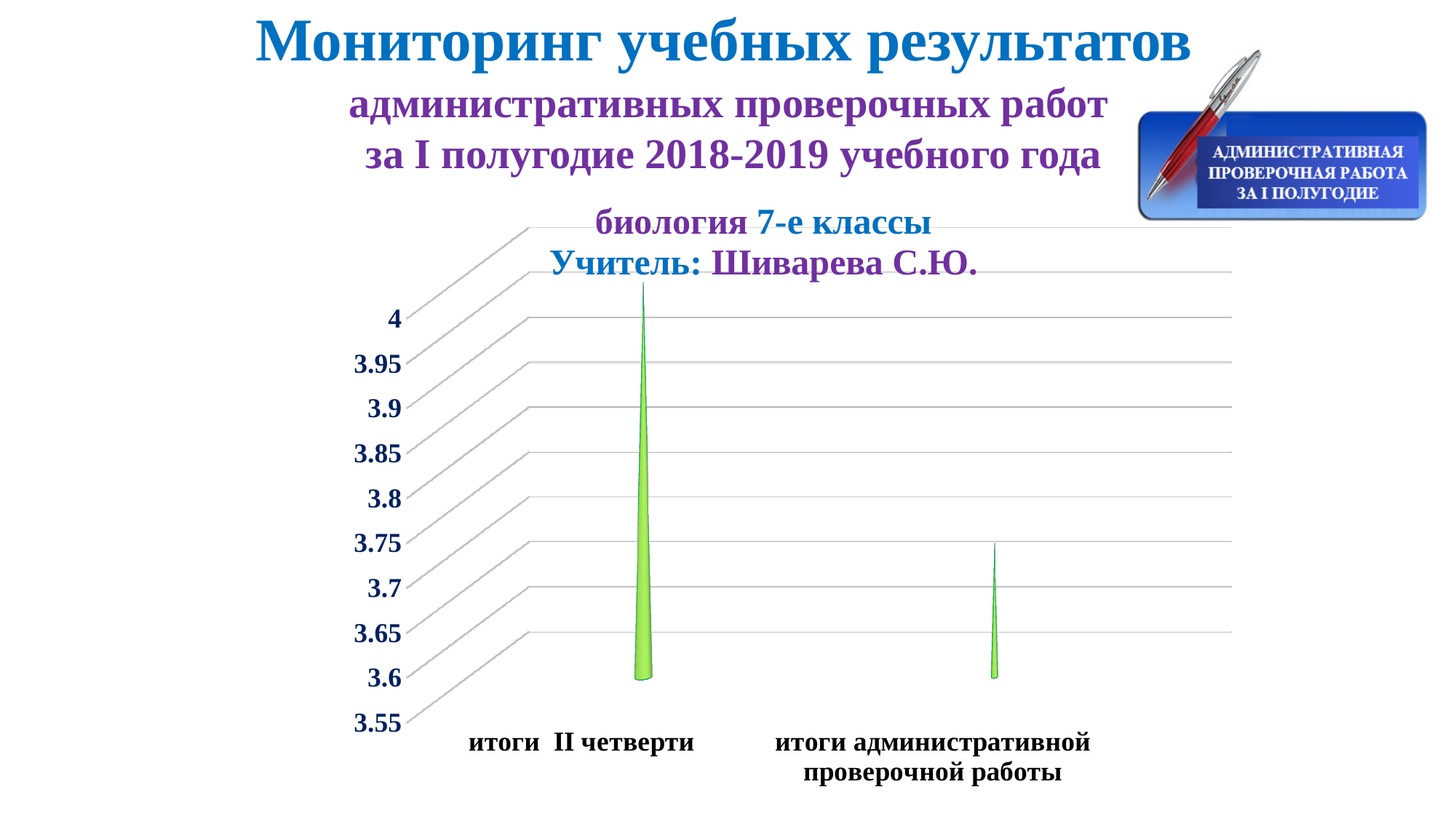
Which subject and classes does the chart title say the results are for? биология 7-е классы Is the value for "итоги административной проверочной работы" greater or less than 3.65? greater What kind of chart is shown on the slide? bar chart Is the value for "итоги административной проверочной работы" greater or less than 3.9? less Do the values rise or fall from left to right along the x axis? fall What is the lowest value shown on the chart's vertical axis? 3.55 Which category has the lowest value in the chart? итоги административной проверочной работы Is the value for "итоги II четверти" greater or less than 3.8? greater How many categories are plotted on the x axis of the chart? 2 Which is larger: the value for "итоги II четверти" or the value for "итоги административной проверочной работы"? итоги II четверти Which category has the highest value in the chart? итоги II четверти